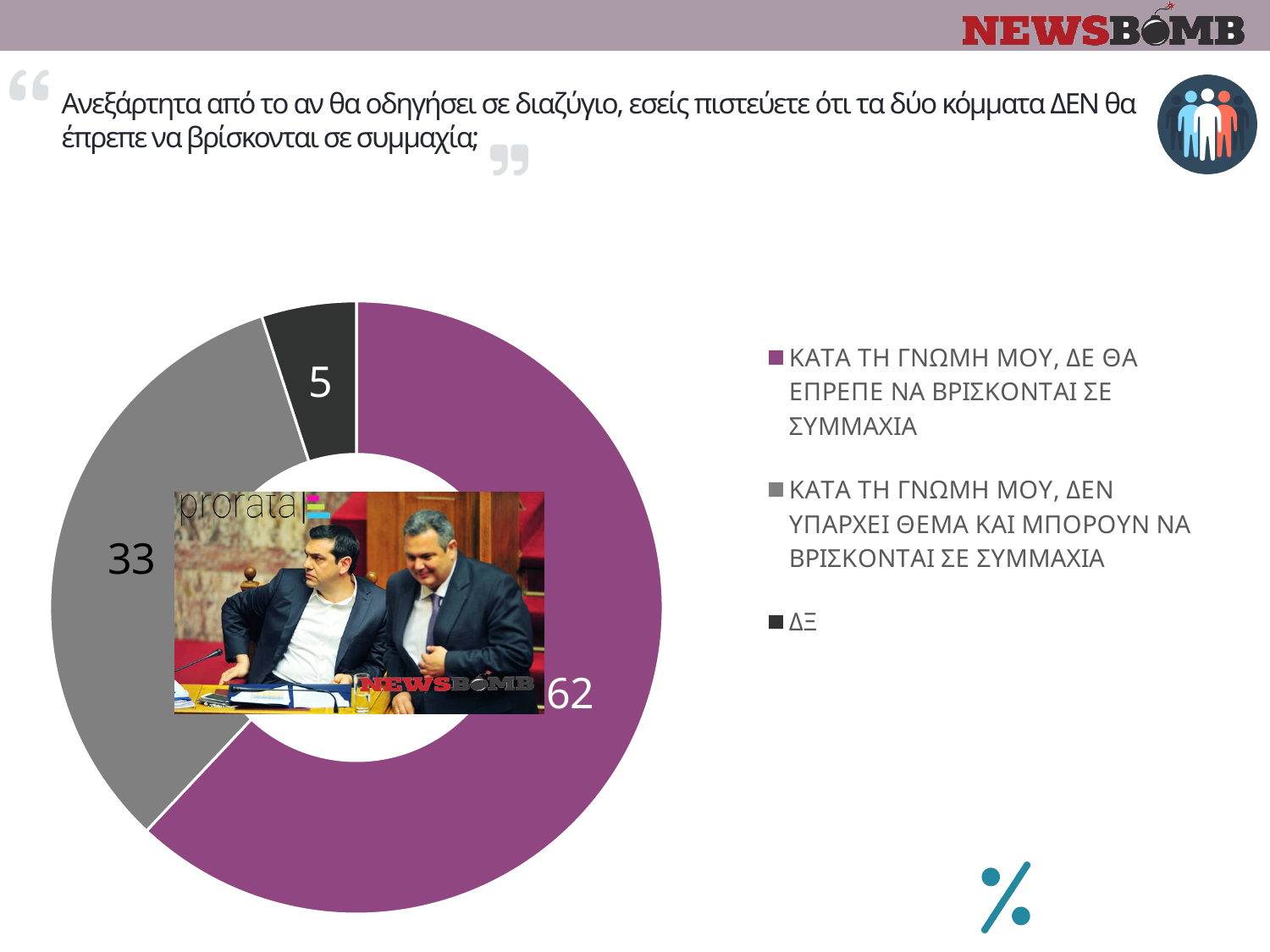
What value is shown for the slice "ΔΞ"? 5 What kind of chart is shown on the slide? Doughnut (pie) chart How many slices does the chart have? 3 Which slice has the largest value? ΚΑΤΑ ΤΗ ΓΝΩΜΗ ΜΟΥ, ΔΕ ΘΑ ΕΠΡΕΠΕ ΝΑ ΒΡΙΣΚΟΝΤΑΙ ΣΕ ΣΥΜΜΑΧΙΑ Which is larger: the value for "ΔΕΝ ΥΠΑΡΧΕΙ ΘΕΜΑ ΚΑΙ ΜΠΟΡΟΥΝ ΝΑ ΒΡΙΣΚΟΝΤΑΙ ΣΕ ΣΥΜΜΑΧΙΑ" or the value for "ΔΞ"? ΔΕΝ ΥΠΑΡΧΕΙ ΘΕΜΑ ΚΑΙ ΜΠΟΡΟΥΝ ΝΑ ΒΡΙΣΚΟΝΤΑΙ ΣΕ ΣΥΜΜΑΧΙΑ Which slice has the smallest value? ΔΞ What value is shown for the slice "ΚΑΤΑ ΤΗ ΓΝΩΜΗ ΜΟΥ, ΔΕ ΘΑ ΕΠΡΕΠΕ ΝΑ ΒΡΙΣΚΟΝΤΑΙ ΣΕ ΣΥΜΜΑΧΙΑ"? 62 What colour is the slice for "ΔΞ"? Dark grey/black How many entries does the legend list? 3 What value is shown for the slice "ΚΑΤΑ ΤΗ ΓΝΩΜΗ ΜΟΥ, ΔΕΝ ΥΠΑΡΧΕΙ ΘΕΜΑ ΚΑΙ ΜΠΟΡΟΥΝ ΝΑ ΒΡΙΣΚΟΝΤΑΙ ΣΕ ΣΥΜΜΑΧΙΑ"? 33 What is the total of the three slice values shown on the chart? 100 What is the difference between the value for "ΔΕ ΘΑ ΕΠΡΕΠΕ ΝΑ ΒΡΙΣΚΟΝΤΑΙ ΣΕ ΣΥΜΜΑΧΙΑ" and the value for "ΔΕΝ ΥΠΑΡΧΕΙ ΘΕΜΑ ΚΑΙ ΜΠΟΡΟΥΝ ΝΑ ΒΡΙΣΚΟΝΤΑΙ ΣΕ ΣΥΜΜΑΧΙΑ"? 29